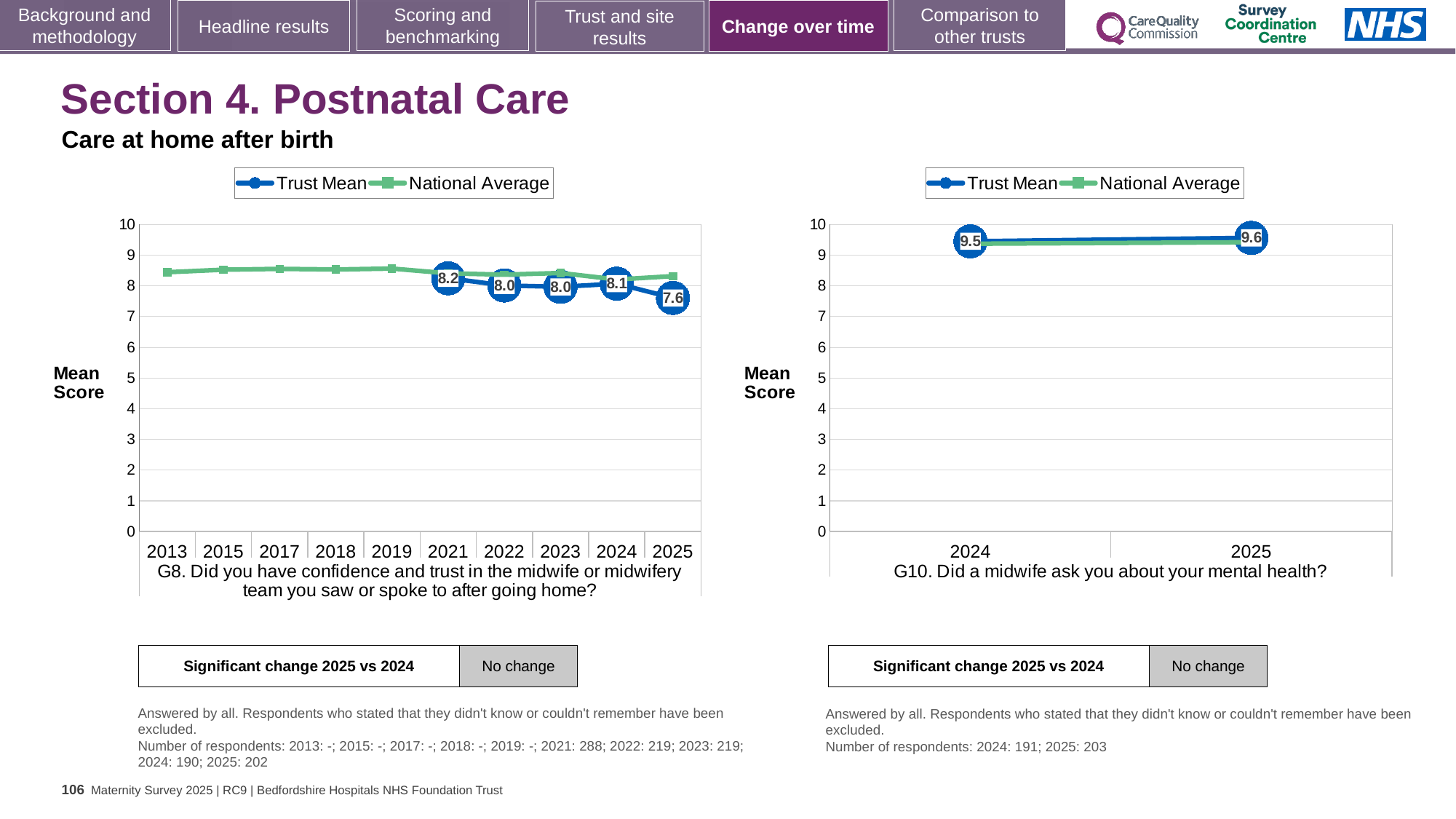
In the left chart (G8), what is the difference between the Trust Mean scores for 2024 and 2025? 0.5 In the left chart (G8), what is the Trust Mean score for 2021? 8.2 In the right chart (G10), what is the Trust Mean score for 2025? 9.6 In the left chart (G8), which year has the lowest labelled Trust Mean score? 2025 In the left chart (G8), is the National Average value for 2013 greater or less than 8? greater In the left chart (G8), what is the Trust Mean score for 2025? 7.6 In the left chart (G8), which year has the highest labelled Trust Mean score? 2021 What kind of chart is the left chart (G8)? Line chart How many years are shown on the x axis of the left chart (G8)? 10 How many series does the legend of the right chart (G10) list? 2 In the right chart (G10), what is the Trust Mean score for 2024? 9.5 In the right chart (G10), does the Trust Mean rise or fall from 2024 to 2025? Rise